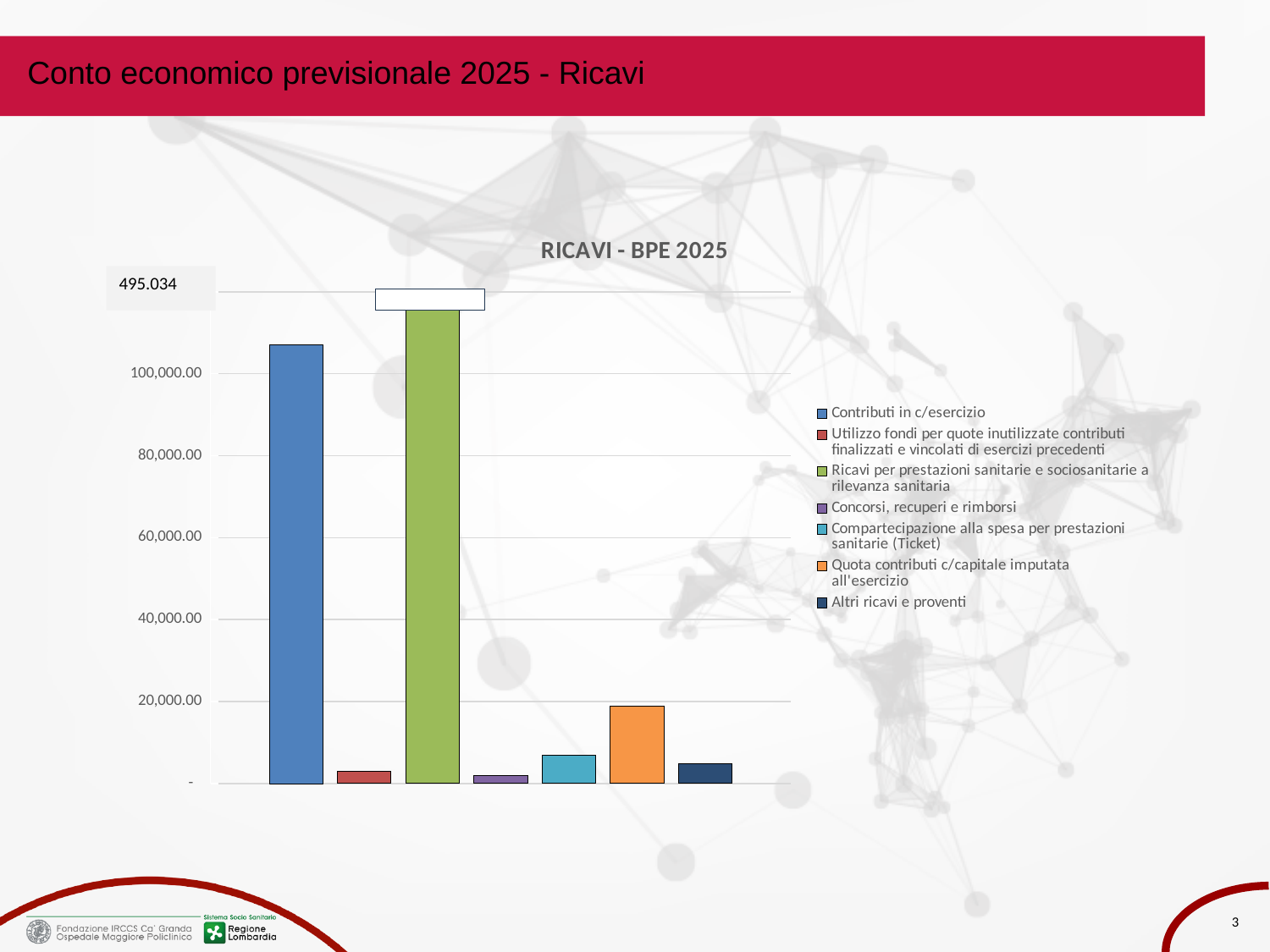
Is the value for Compartecipazione alla spesa per prestazioni sanitarie (Ticket) greater or less than 20,000.00? less What colour is the bar for Quota contributi c/capitale imputata all'esercizio? orange What type of chart is shown on the slide? bar chart How many bars are plotted in the chart? 7 Which series has the highest value in the chart? Ricavi per prestazioni sanitarie e sociosanitarie a rilevanza sanitaria Is the value for Ricavi per prestazioni sanitarie e sociosanitarie a rilevanza sanitaria greater or less than 100,000.00? greater How many series does the legend list? 7 What is the title of the chart? RICAVI - BPE 2025 Which is larger: Contributi in c/esercizio or Altri ricavi e proventi? Contributi in c/esercizio Is the value for Contributi in c/esercizio greater or less than 100,000.00? greater Which is larger: Quota contributi c/capitale imputata all'esercizio or Compartecipazione alla spesa per prestazioni sanitarie (Ticket)? Quota contributi c/capitale imputata all'esercizio